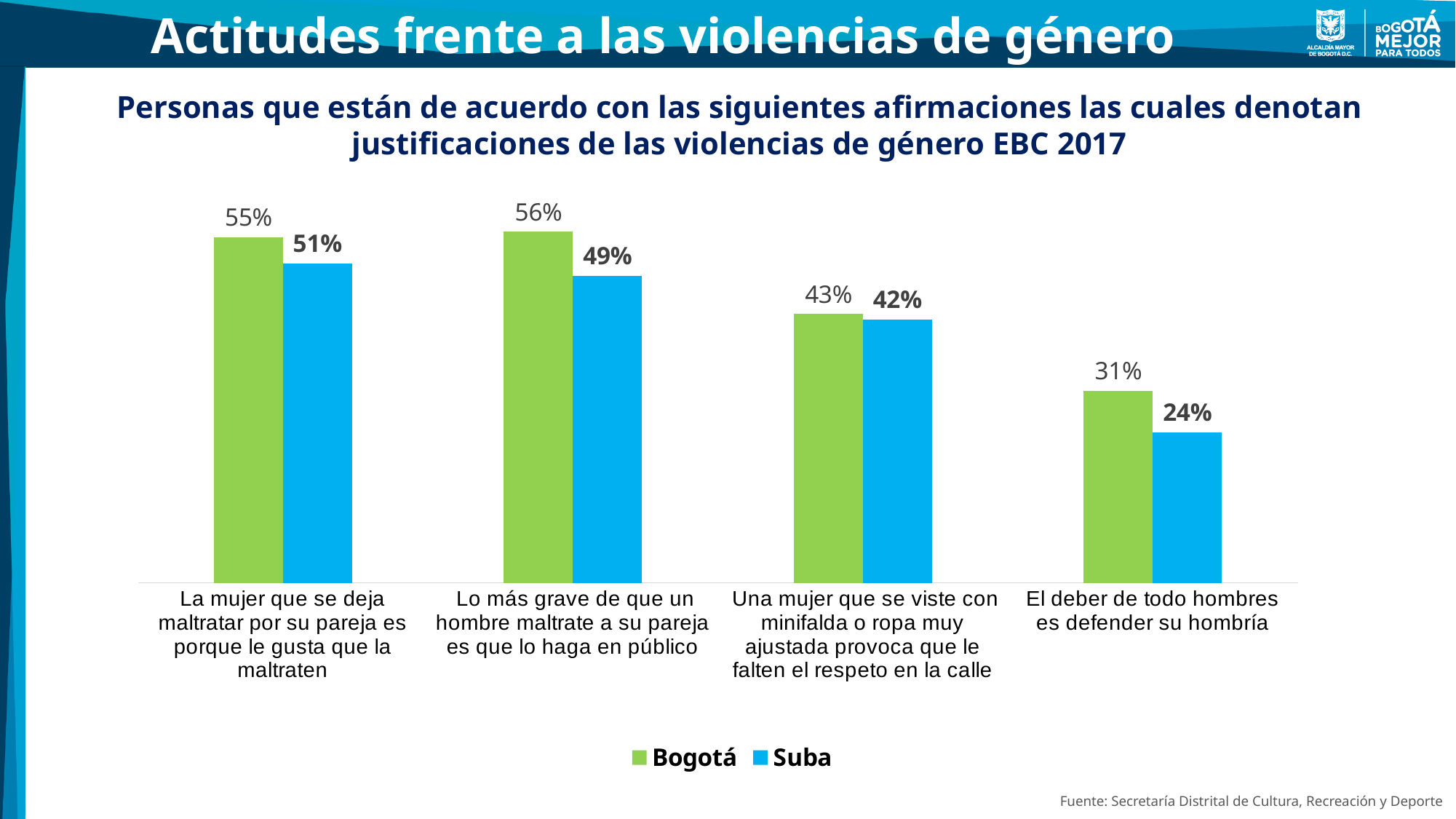
What kind of chart is shown on the slide? Bar chart How many categories are shown on the x axis? 4 What is the Suba value for "Lo más grave de que un hombre maltrate a su pareja es que lo haga en público"? 49% Which colour represents Suba in the legend? Blue What is the Bogotá value for "El deber de todo hombres es defender su hombría"? 31% Which category has the lowest Suba value? El deber de todo hombres es defender su hombría What is the difference between the Bogotá and Suba values for "El deber de todo hombres es defender su hombría"? 7% How many series does the legend list? 2 Do the Suba values rise or fall from left to right across the categories? Fall Which category has the highest Bogotá value? Lo más grave de que un hombre maltrate a su pareja es que lo haga en público For "La mujer que se deja maltratar por su pareja es porque le gusta que la maltraten", which series has the larger value, Bogotá or Suba? Bogotá What is the Suba value for "Una mujer que se viste con minifalda o ropa muy ajustada provoca que le falten el respeto en la calle"? 42%